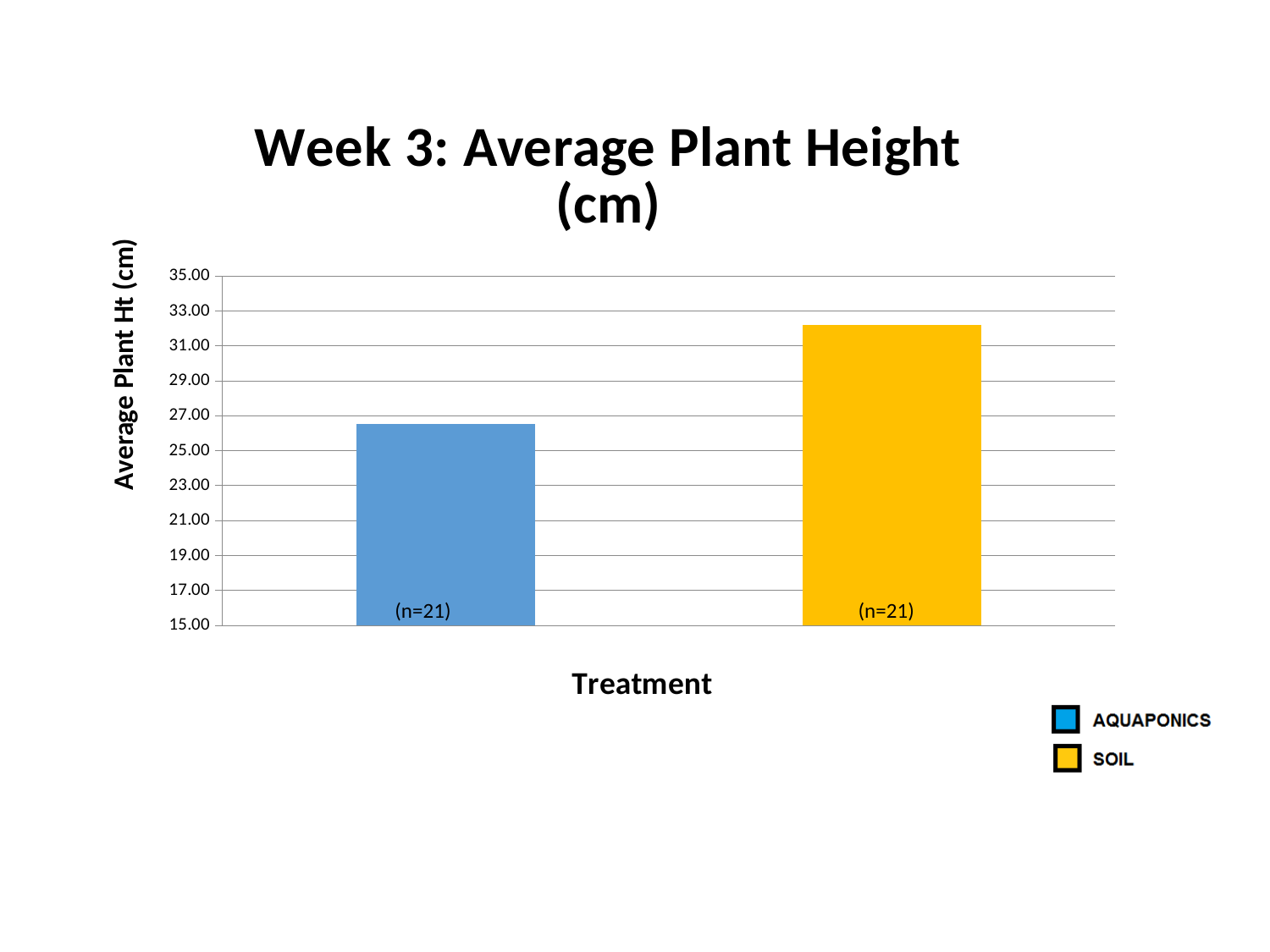
Is the average plant height for Soil larger or smaller than for Aquaponics? larger Is the value for Aquaponics greater or less than 25.00? greater Is the value for Aquaponics greater or less than 29.00? less Is the value for Soil greater or less than 33.00? less What sample size is printed on each bar? (n=21) What kind of chart is shown on the slide? bar chart What is the title of the chart? Week 3: Average Plant Height (cm) How many bars are plotted in the chart? 2 How many entries does the legend list? 2 Which treatment has the lower average plant height? Aquaponics Which treatment has the greater average plant height? Soil